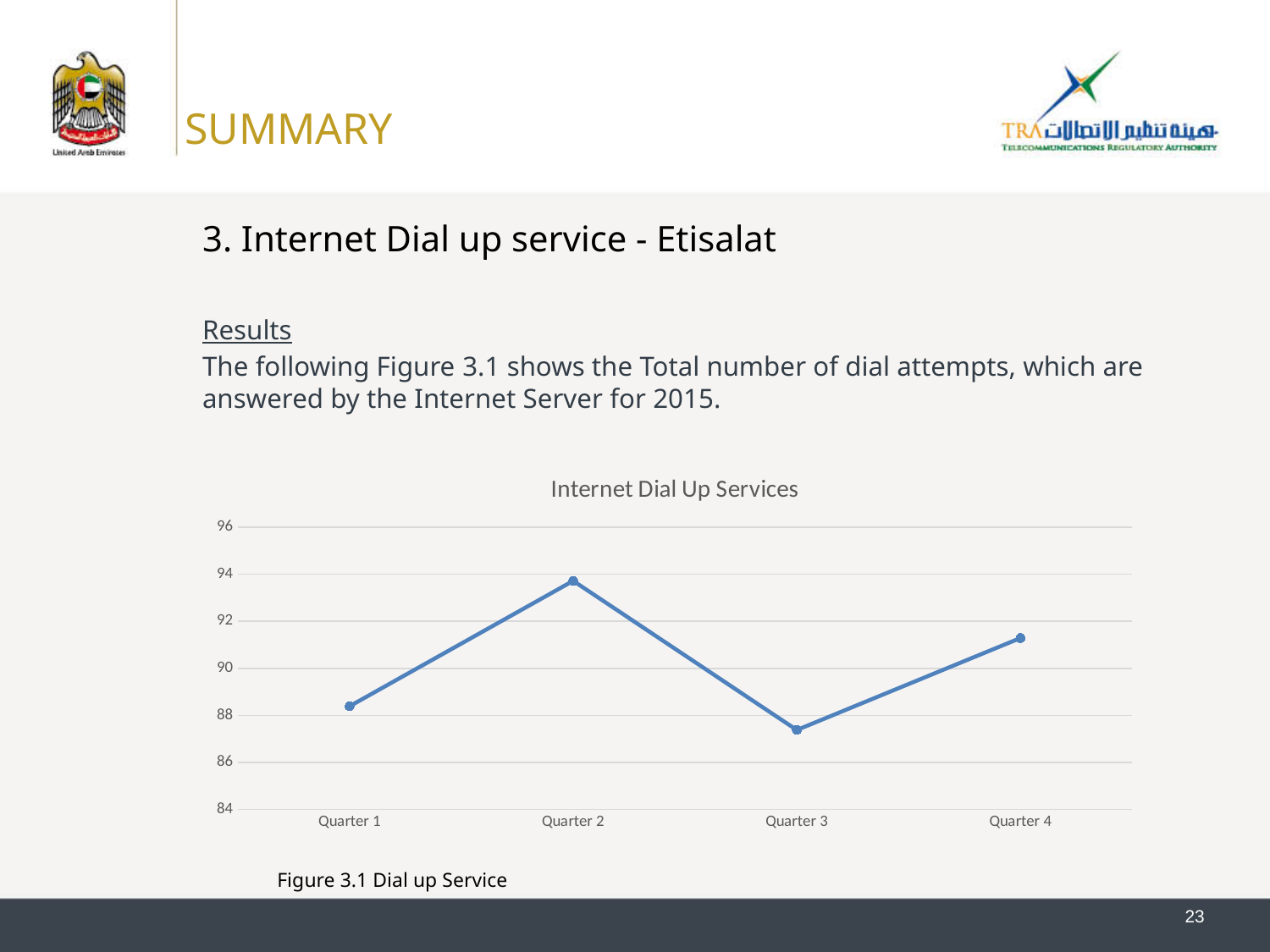
Which quarter has the highest value? Quarter 2 Is the value for Quarter 4 greater or less than 90? greater Is the value for Quarter 2 greater or less than 92? greater Which is larger, the value for Quarter 2 or Quarter 4? Quarter 2 What is the title of the chart? Internet Dial Up Services How many quarters are plotted on the chart? 4 Does the value rise or fall from Quarter 2 to Quarter 3? fall Does the value rise or fall from Quarter 3 to Quarter 4? rise Is the value for Quarter 1 greater or less than 90? less What type of chart is shown on the slide? line chart Which quarter has the lowest value? Quarter 3